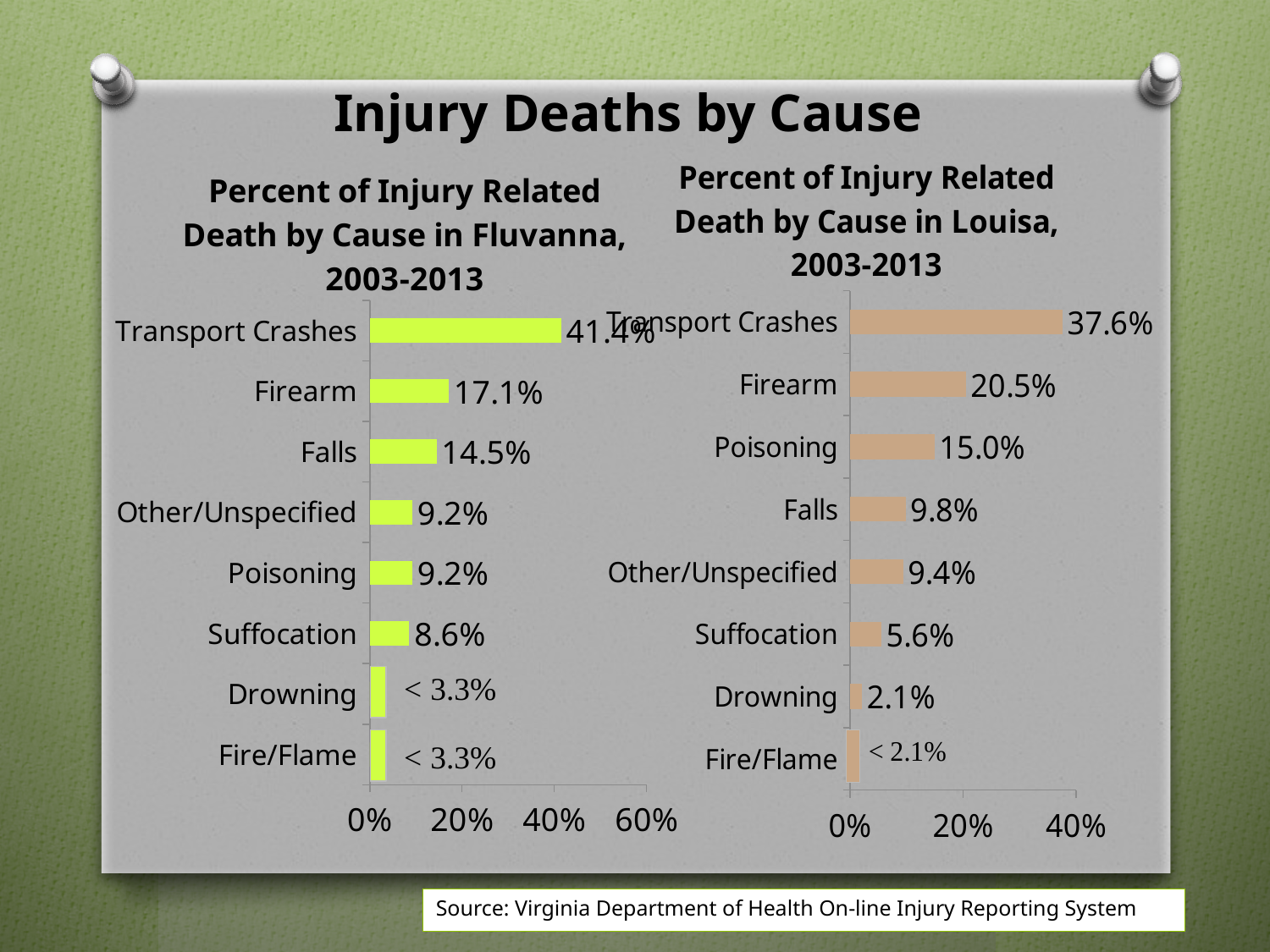
In the Louisa chart, what is the value for Poisoning? 15.0% In the Fluvanna chart, what is the difference between the Transport Crashes and Firearm percentages? 24.3% In the Fluvanna chart, what percent of injury-related deaths were due to Transport Crashes? 41.4% In the Louisa chart, which cause has the lowest percentage? Fire/Flame In the Louisa chart, which cause has the highest percentage? Transport Crashes How many causes are listed in the Louisa chart? 8 In the Louisa chart, what is the difference between the Firearm and Poisoning percentages? 5.5% In the Fluvanna chart, is the value for Transport Crashes greater or less than 40%? greater What type of chart is used to show the Fluvanna data? Bar chart Is the Firearm percentage higher in the Fluvanna chart or the Louisa chart? Louisa In the Fluvanna chart, what is the value for Suffocation? 8.6% In the Louisa chart, what percent of injury-related deaths were due to Firearm? 20.5%